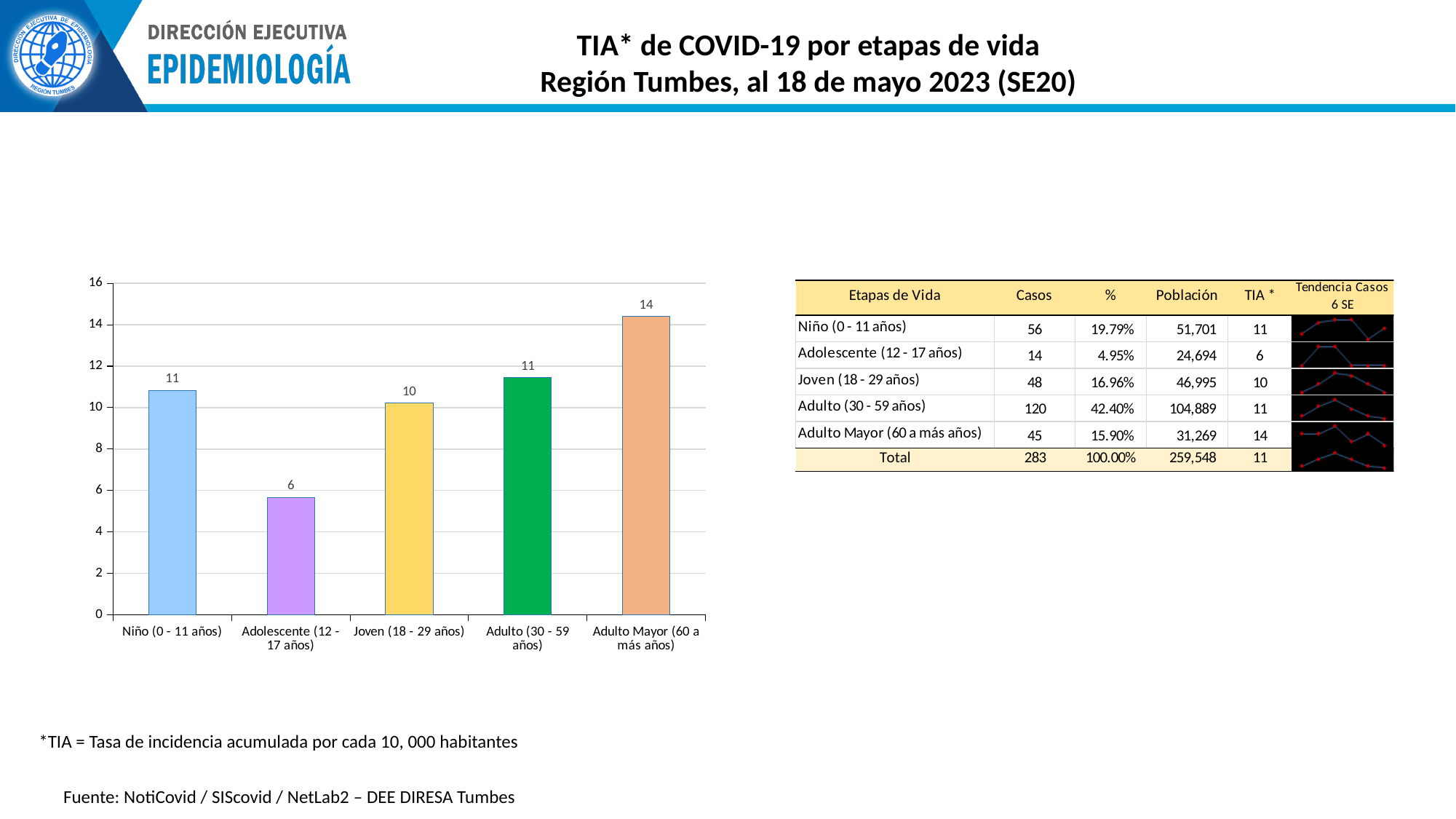
Is the value for Joven (18 - 29 años) greater or less than 8? greater What is the TIA value shown for Adulto Mayor (60 a más años) in the bar chart? 14 Which is larger in the bar chart, the value for Joven (18 - 29 años) or the value for Adolescente (12 - 17 años)? Joven (18 - 29 años) Which life stage has the lowest bar in the chart? Adolescente (12 - 17 años) What is the difference between the labelled values for Adulto Mayor (60 a más años) and Adolescente (12 - 17 años)? 8 Is the value for Adolescente (12 - 17 años) greater or less than 8? less What is the TIA value shown for Adolescente (12 - 17 años) in the bar chart? 6 How many life-stage categories are plotted in the bar chart? 5 What is the TIA value shown for Joven (18 - 29 años) in the bar chart? 10 What kind of chart is used to show the TIA by life stage? bar chart Which life stage has the highest bar in the chart? Adulto Mayor (60 a más años) What colour is the bar for Adulto (30 - 59 años)? green